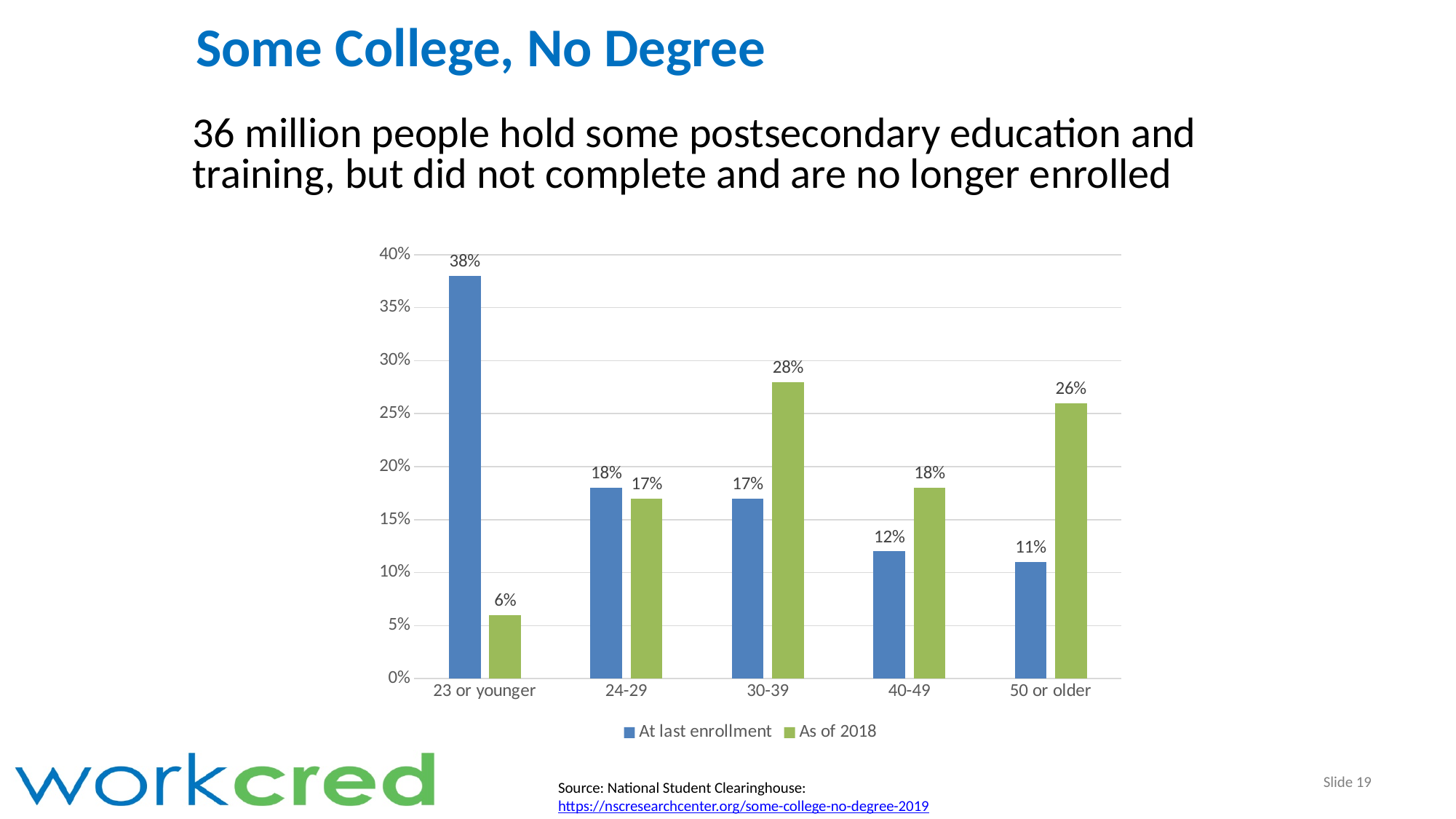
For the "40-49" group, which series has the larger value, "At last enrollment" or "As of 2018"? As of 2018 How many series does the legend list? 2 Is the "As of 2018" value for "50 or older" greater or less than 20%? greater Which age group has the highest value in the "As of 2018" series? 30-39 What kind of chart is shown on the slide? Bar chart How many age groups are shown on the x axis? 5 What is the difference between the "At last enrollment" and "As of 2018" values for "23 or younger"? 32% What is the value for "23 or younger" in the "At last enrollment" series? 38% What is the value for "30-39" in the "As of 2018" series? 28% What is the value for "50 or older" in the "As of 2018" series? 26% Which colour represents the "As of 2018" series? Green Which age group has the lowest value in the "At last enrollment" series? 50 or older